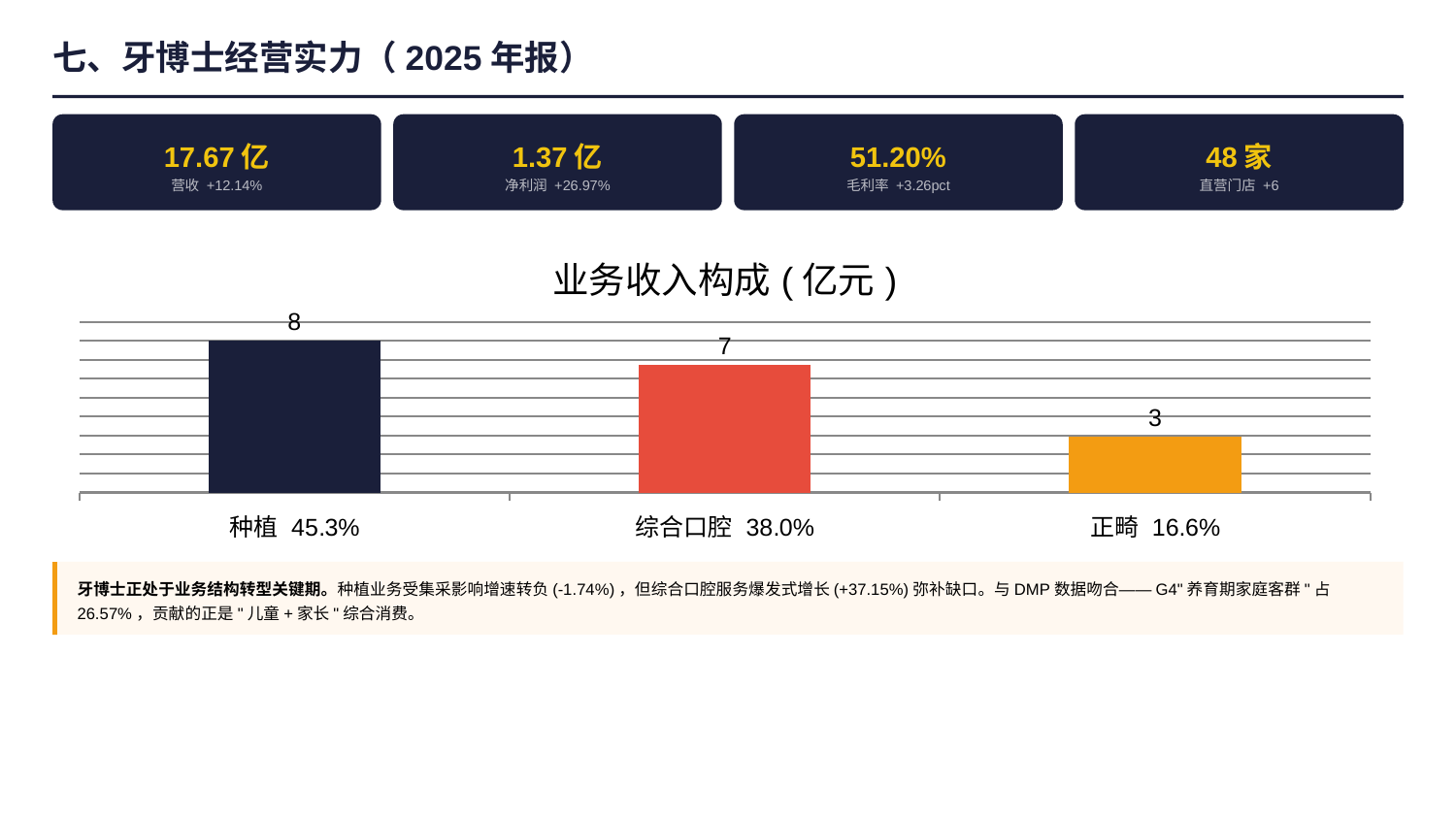
What is the difference between the values for 综合口腔 and 正畸 in the 业务收入构成 chart? 4 What is the value for 种植 in the 业务收入构成 chart? 8 What kind of chart is the 业务收入构成 chart? bar chart Which category has the lowest value in the 业务收入构成 chart? 正畸 Which category has the highest value in the 业务收入构成 chart? 种植 How many categories are shown in the 业务收入构成 chart? 3 Which is larger in the 业务收入构成 chart, the value for 综合口腔 or the value for 正畸? 综合口腔 What percentage share is printed next to the 综合口腔 category label in the 业务收入构成 chart? 38.0% Do the values in the 业务收入构成 chart rise or fall from left to right? fall What is the difference between the values for 种植 and 正畸 in the 业务收入构成 chart? 5 What is the value for 综合口腔 in the 业务收入构成 chart? 7 What is the value for 正畸 in the 业务收入构成 chart? 3